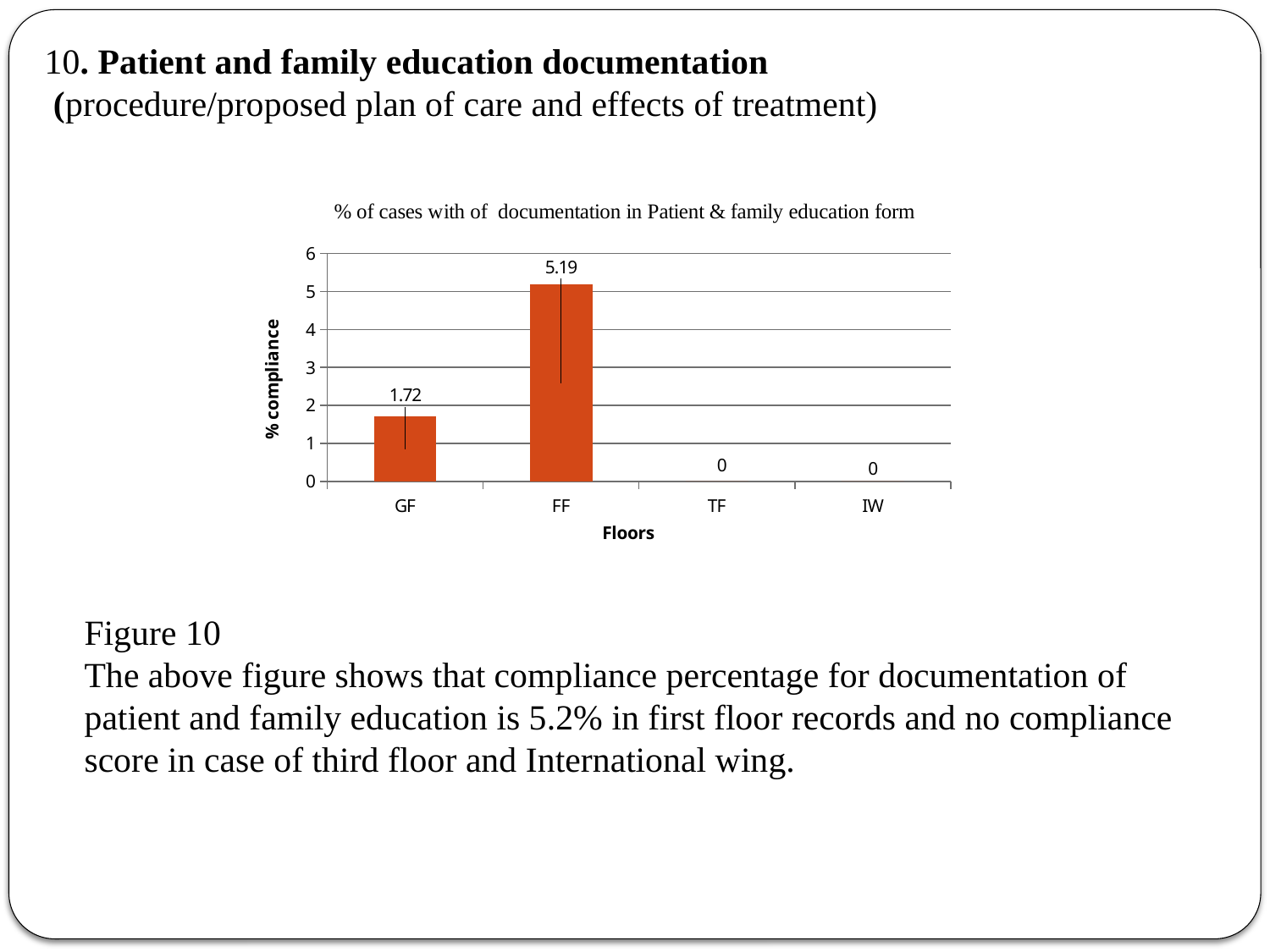
What is the title of the chart? % of cases with of documentation in Patient & family education form What is the difference between the values for FF and GF? 3.47 Is the value for FF greater or less than 5? greater Which floor has the highest % compliance? FF What is the value for GF? 1.72 What is the label of the y axis? % compliance What kind of chart is shown? bar chart What is the value for IW? 0 Which is larger, the value for GF or the value for FF? FF What is the value for TF? 0 What is the value for FF? 5.19 How many floors are shown on the x axis? 4